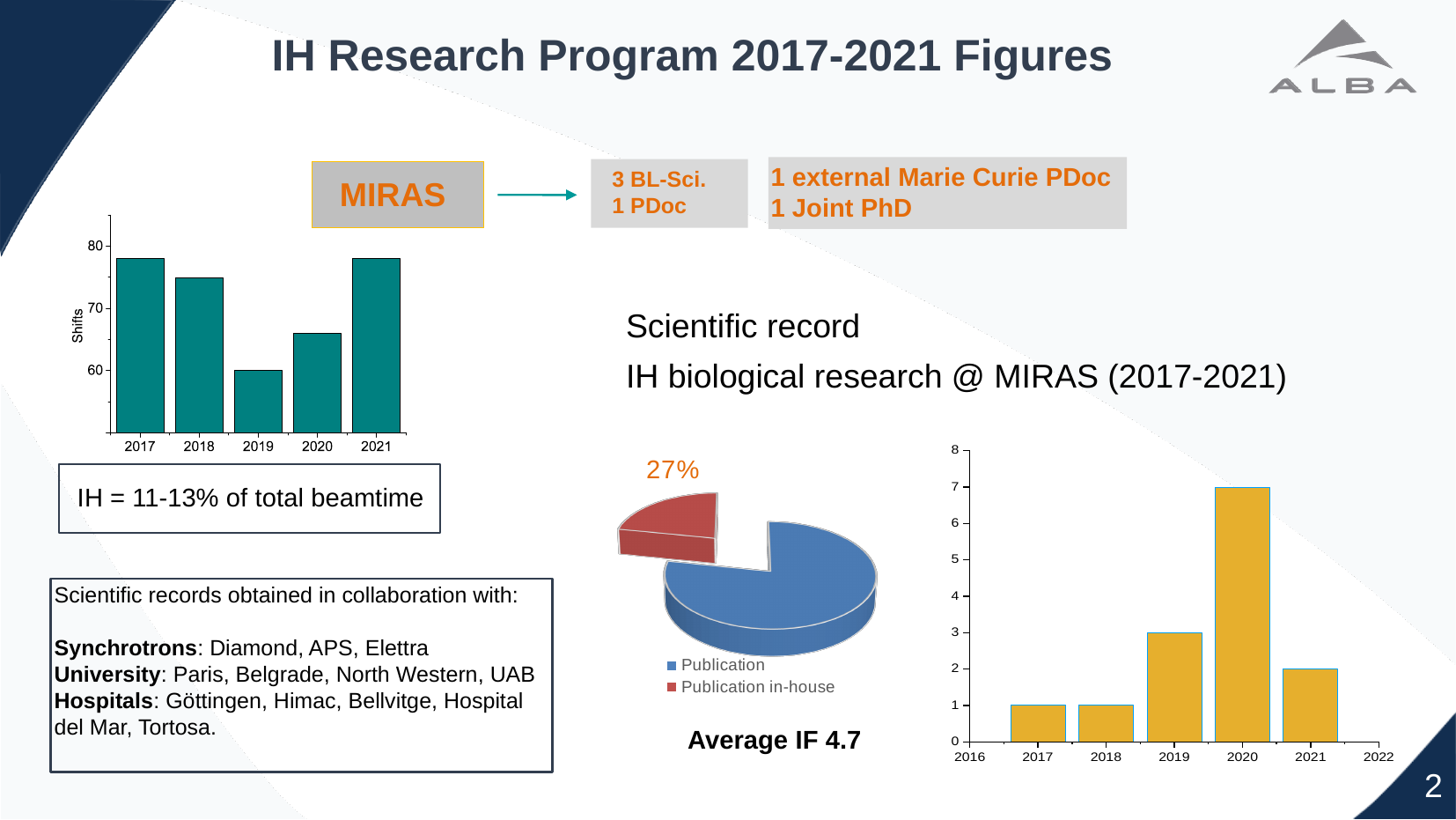
In the bar chart on the right (publications by year), is the value for 2021 larger or smaller than the value for 2019? smaller In the Shifts bar chart on the left, is the value for 2020 greater or less than 70? less In the Shifts bar chart on the left, is the value for 2018 greater or less than 70? greater In the bar chart on the right (publications by year), what is the difference between the values for 2020 and 2019? 4 In the bar chart on the right (publications by year), what is the value for 2019? 3 In the bar chart on the right (publications by year), what is the value for 2020? 7 In the bar chart on the right (publications by year), which year has the highest value? 2020 How many entries does the legend of the pie chart list? 2 In the Shifts bar chart on the left, which year has the lowest value? 2019 In the bar chart on the right (publications by year), what is the value for 2021? 2 In the bar chart on the right (publications by year), how many years have bars plotted? 5 In the pie chart, what share is labelled for the Publication in-house slice? 27%